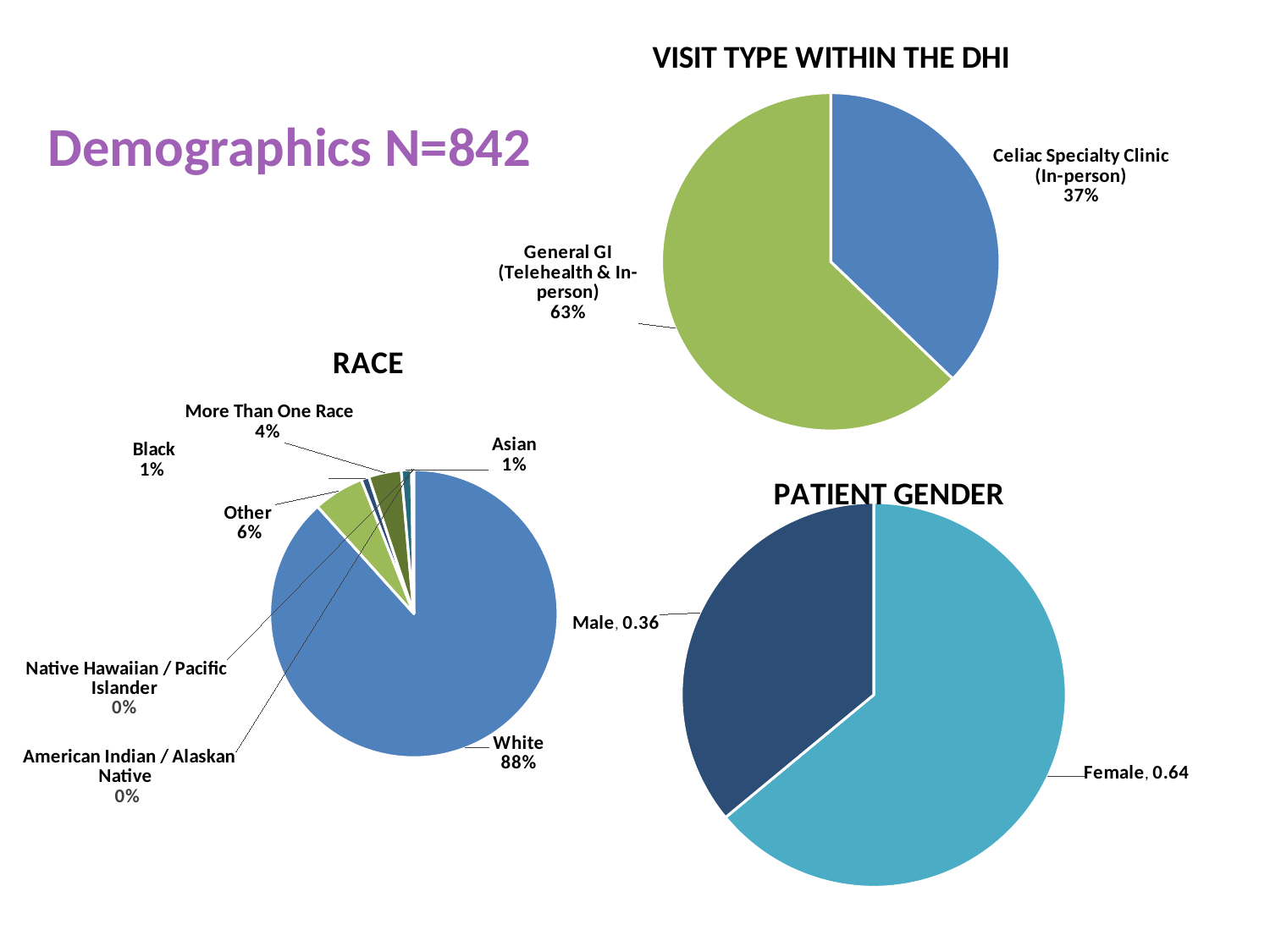
In the PATIENT GENDER chart, what is the value for Female? 0.64 What kind of chart is the PATIENT GENDER chart? Pie chart In the VISIT TYPE WITHIN THE DHI chart, what is the difference in percentage points between General GI and Celiac Specialty Clinic? 26 In the VISIT TYPE WITHIN THE DHI chart, which visit type has the larger share? General GI (Telehealth & In-person) In the RACE chart, which category has the largest share? White In the PATIENT GENDER chart, what is the value for Male? 0.36 In the VISIT TYPE WITHIN THE DHI chart, what share of visits is General GI (Telehealth & In-person)? 63% In the VISIT TYPE WITHIN THE DHI chart, what share of visits is Celiac Specialty Clinic (In-person)? 37% In the RACE chart, what share is More Than One Race? 4% In the RACE chart, how many race categories are shown? 7